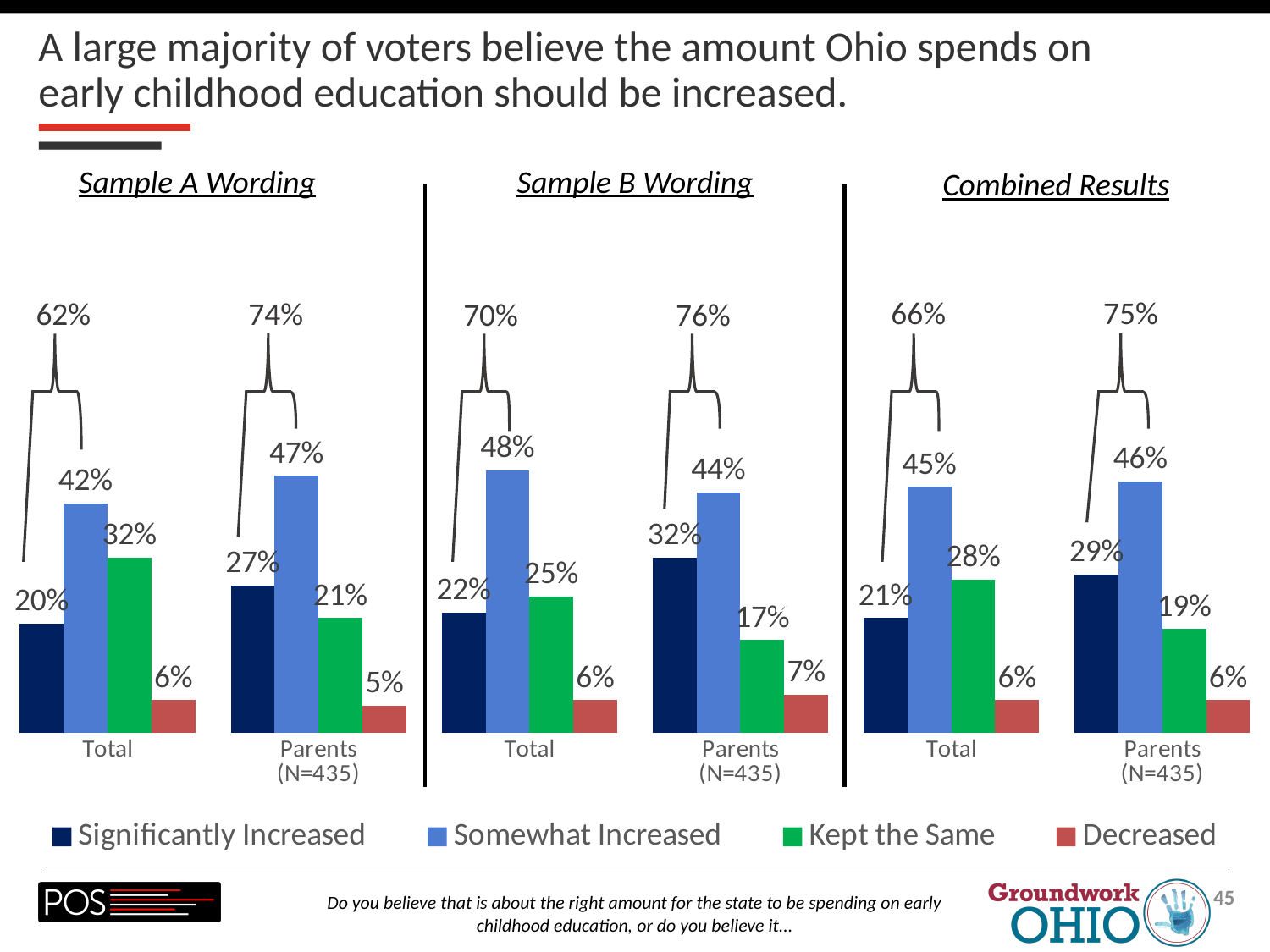
What kind of chart is the Combined Results chart? Bar chart In the Sample A Wording chart, what is the value for Somewhat Increased for Total? 42% In the Combined Results chart, what is the value for Decreased for Parents (N=435)? 6% In the Sample B Wording chart, which series has the lowest value for Total? Decreased How many series does the legend list? 4 In the Combined Results chart, which is larger: Significantly Increased for Total or Significantly Increased for Parents (N=435)? Parents (N=435) In the Sample A Wording chart, what is the combined increased share shown above the bracket for Total? 62% How many categories are shown on the x axis of the Sample B Wording chart? 2 In the Combined Results chart, what is the value for Kept the Same for Total? 28% In the Sample A Wording chart, which series has the highest value for Parents (N=435)? Somewhat Increased In the Sample B Wording chart, what is the difference between Somewhat Increased for Total and Somewhat Increased for Parents (N=435)? 4% In the Sample B Wording chart, what is the value for Significantly Increased for Parents (N=435)? 32%